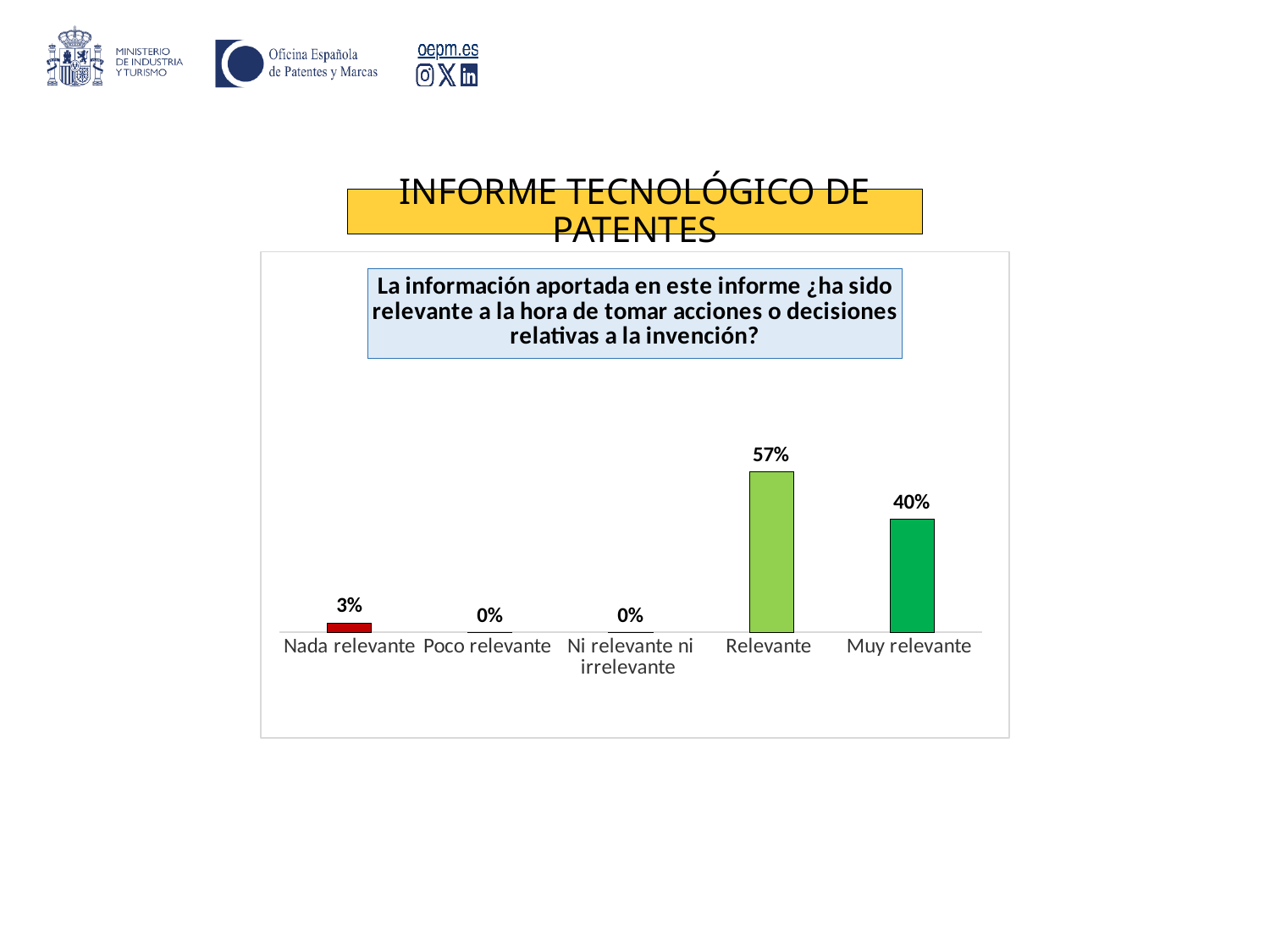
What is the value for Poco relevante? 0% How many categories are shown on the x axis? 5 Which is larger, the value for Nada relevante or the value for Muy relevante? Muy relevante What is the difference between the values for Muy relevante and Nada relevante? 37% What is the difference between the values for Relevante and Muy relevante? 17% What colour is the bar for Nada relevante? Red What is the value for Muy relevante? 40% What is the value for Relevante? 57% How many categories have a value of 0%? 2 Which category has the highest value? Relevante What kind of chart is shown on the slide? Bar chart What is the value for Nada relevante? 3%